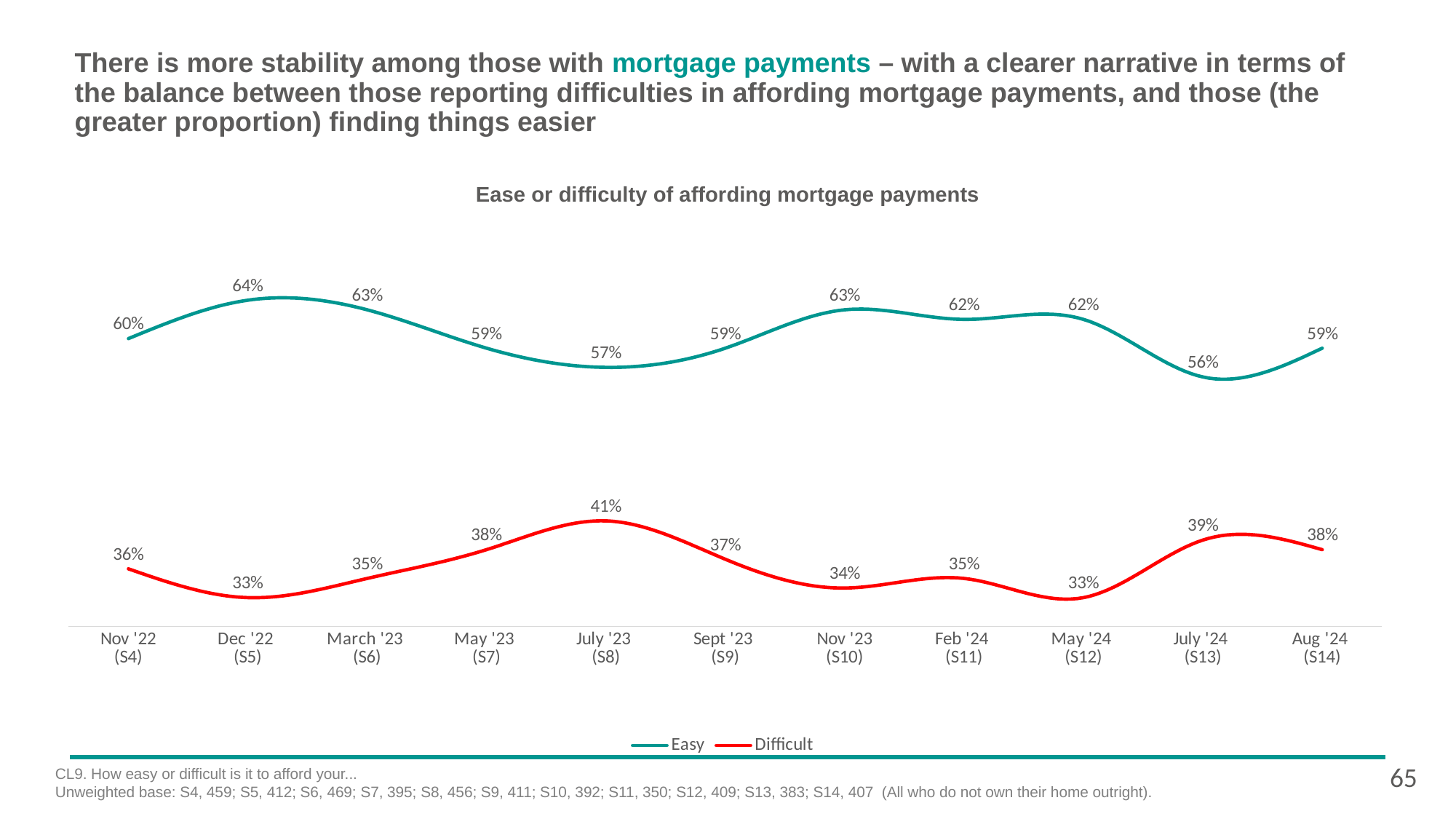
Does the Difficult series rise or fall from May '24 (S12) to July '24 (S13)? Rise What kind of chart is shown? Line chart What is the value for Easy in Aug '24 (S14)? 59% What is the title of the chart? Ease or difficulty of affording mortgage payments How many series does the legend list? 2 What is the difference between Easy and Difficult in Nov '22 (S4)? 24 percentage points In which period is the Difficult series at its highest? July '23 (S8) What is the value for Easy in Dec '22 (S5)? 64% In which period is the Easy series at its lowest? July '24 (S13) Which is larger in July '24 (S13): Easy or Difficult? Easy What is the value for Difficult in July '23 (S8)? 41% How many time periods are shown on the x axis? 11